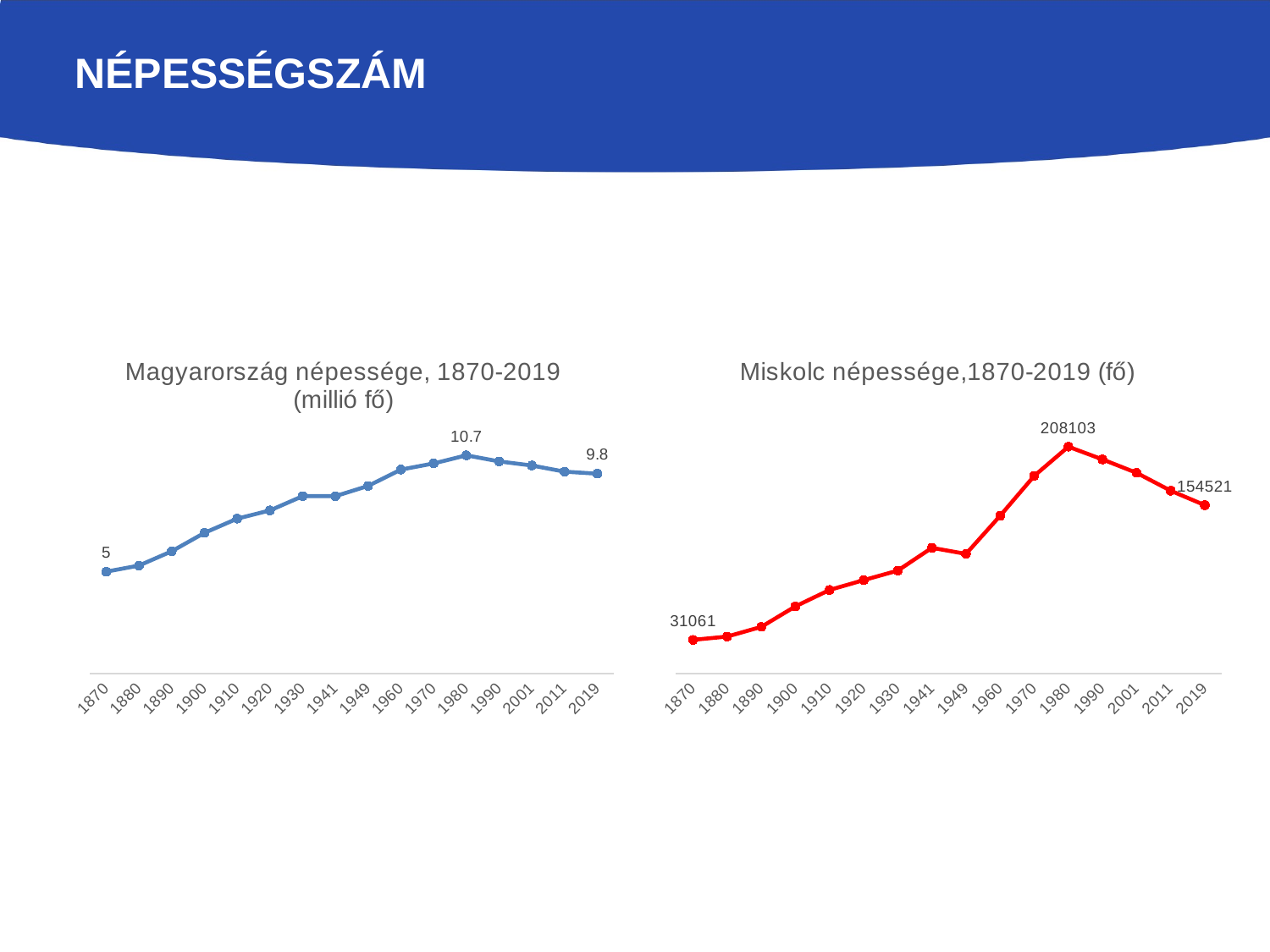
What kind of chart is the chart on the left of the slide? Line chart In the chart titled "Miskolc népessége,1870-2019 (fő)", what is the value for 1870? 31061 In the chart titled "Magyarország népessége, 1870-2019 (millió fő)", which year has the lowest value? 1870 In the chart titled "Magyarország népessége, 1870-2019 (millió fő)", what is the difference between the values for 1980 and 2019? 0.9 In the chart titled "Miskolc népessége,1870-2019 (fő)", what is the value for 2019? 154521 In the chart titled "Magyarország népessége, 1870-2019 (millió fő)", what is the value for 1870? 5 How many data points are plotted in the chart titled "Miskolc népessége,1870-2019 (fő)"? 16 In the chart titled "Magyarország népessége, 1870-2019 (millió fő)", what is the value for 2019? 9.8 In the chart titled "Magyarország népessége, 1870-2019 (millió fő)", what is the value for 1980? 10.7 In the chart titled "Miskolc népessége,1870-2019 (fő)", what is the value for 1980? 208103 In the chart titled "Miskolc népessége,1870-2019 (fő)", what is the difference between the values for 1980 and 2019? 53582 In the chart titled "Miskolc népessége,1870-2019 (fő)", which year has the highest value? 1980